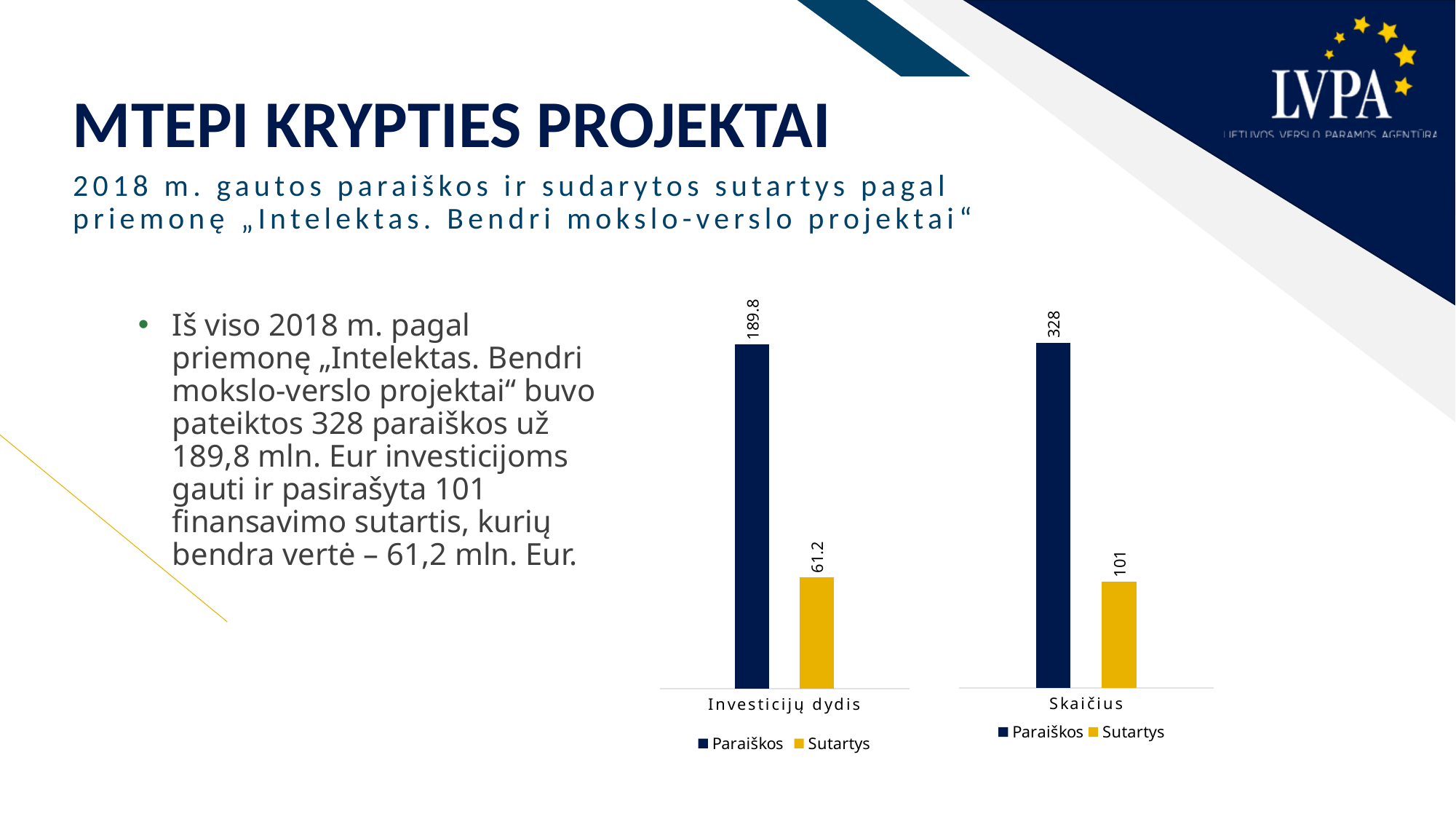
In the right chart (Skaičius), what colour are the Sutartys bars? yellow How many series does the legend of the right chart (Skaičius) list? 2 In the right chart (Skaičius), what is the value for Paraiškos? 328 In the right chart (Skaičius), which series has the higher value? Paraiškos In the left chart (Investicijų dydis), which series has the lower value? Sutartys In the right chart (Skaičius), what is the value for Sutartys? 101 In the left chart (Investicijų dydis), what is the value for Paraiškos? 189.8 What kind of chart is the left chart (Investicijų dydis)? bar chart In the right chart (Skaičius), what is the difference between Paraiškos and Sutartys? 227 In the left chart (Investicijų dydis), is the value for Paraiškos larger or smaller than the value for Sutartys? larger In the left chart (Investicijų dydis), what is the value for Sutartys? 61.2 In the left chart (Investicijų dydis), what is the difference between Paraiškos and Sutartys? 128.6